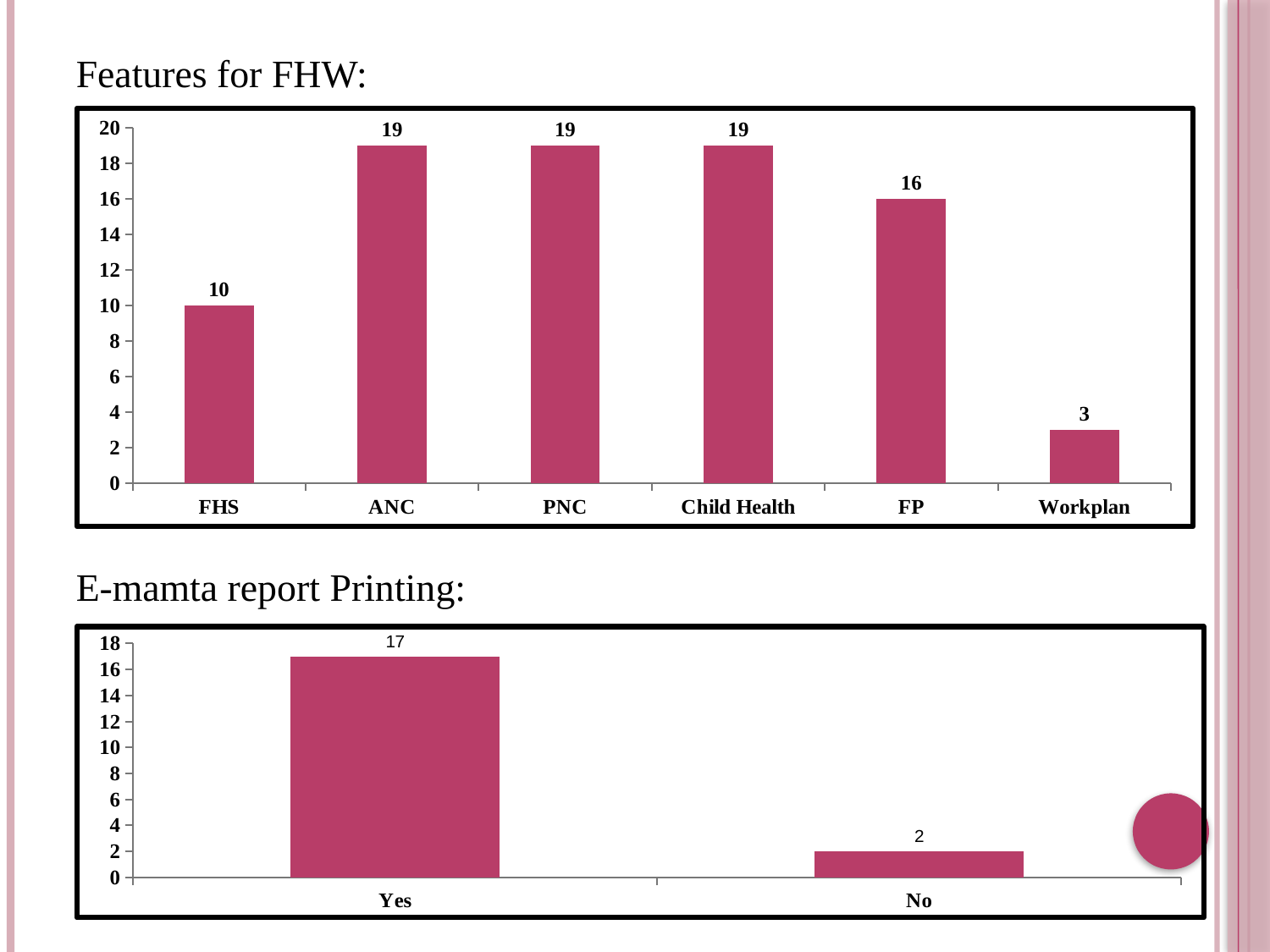
In the 'Features for FHW' chart, how many categories are shown on the x axis? 6 In the 'E-mamta report Printing' chart, what is the value for Yes? 17 In the 'Features for FHW' chart, how many categories have a value of 19? 3 In the 'E-mamta report Printing' chart, what is the value for No? 2 In the 'Features for FHW' chart, which category has the lowest value? Workplan In the 'E-mamta report Printing' chart, what is the difference between the values for Yes and No? 15 What kind of chart is the 'Features for FHW' chart? Bar chart In the 'Features for FHW' chart, what is the difference between the values for ANC and Workplan? 16 In the 'Features for FHW' chart, which is larger, the value for FHS or the value for FP? FP In the 'E-mamta report Printing' chart, how many categories are shown on the x axis? 2 In the 'Features for FHW' chart, what is the value for FHS? 10 In the 'Features for FHW' chart, what is the value for FP? 16